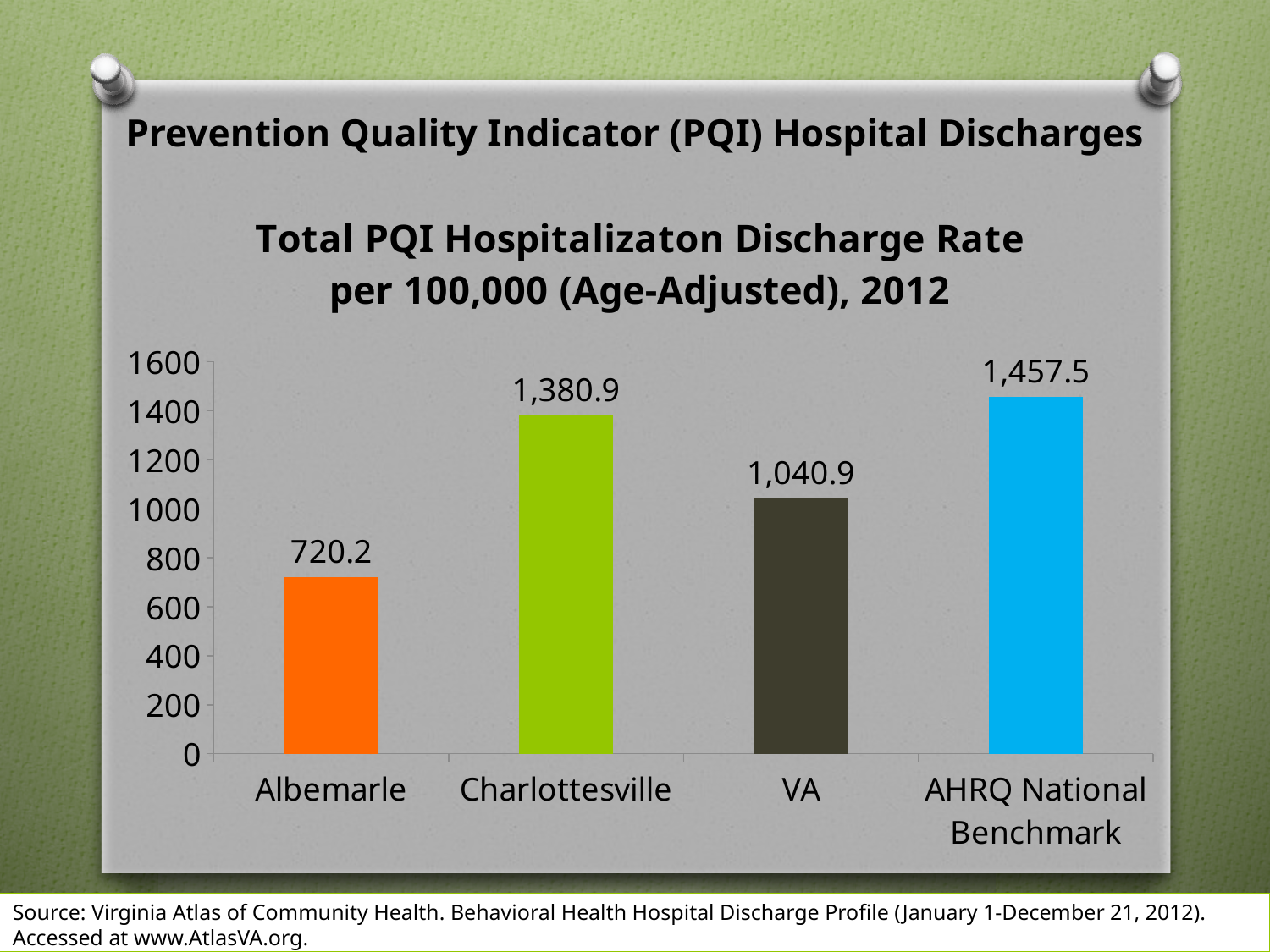
What is the value shown for the AHRQ National Benchmark? 1,457.5 What is the Total PQI Hospitalization Discharge Rate for Charlottesville? 1,380.9 Which category has the highest Total PQI Hospitalization Discharge Rate? AHRQ National Benchmark What kind of chart is shown on the slide? Bar chart Which is larger, the rate for Charlottesville or the rate for VA? Charlottesville What is the Total PQI Hospitalization Discharge Rate for VA? 1,040.9 What is the Total PQI Hospitalization Discharge Rate for Albemarle? 720.2 What is the title of the chart? Total PQI Hospitalizaton Discharge Rate per 100,000 (Age-Adjusted), 2012 What is the difference between the Charlottesville rate and the Albemarle rate? 660.7 Which category has the lowest Total PQI Hospitalization Discharge Rate? Albemarle How many categories are shown on the x axis of the chart? 4 What is the difference between the AHRQ National Benchmark and the VA rate? 416.6